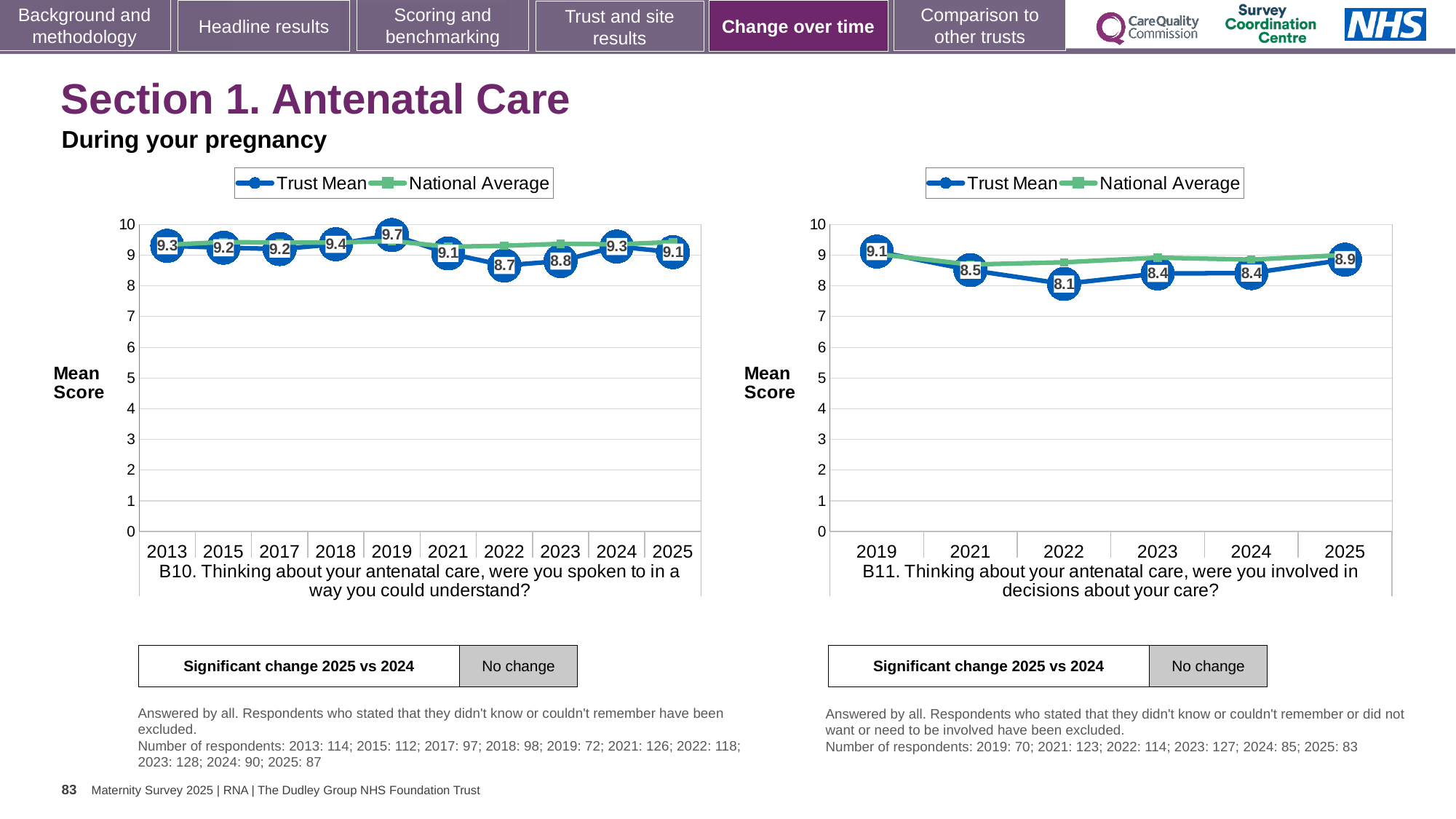
In the B10 chart (left), what is the difference between the Trust Mean scores for 2019 and 2022? 1.0 In the B11 chart (right), what is the Trust Mean score for 2025? 8.9 In the B10 chart (left), what is the Trust Mean score for 2019? 9.7 In the B10 chart (left), how many years are shown on the x axis? 10 In the B11 chart (right), which year has the lowest Trust Mean score? 2022 In the B11 chart (right), is the Trust Mean value for 2022 greater or less than 9? less How many series does the legend of the B11 chart (right) list? 2 What kind of chart is the B10 chart (left)? Line chart In the B11 chart (right), is the Trust Mean score for 2019 or 2021 higher? 2019 In the B10 chart (left), which year has the lowest Trust Mean score? 2022 In the B10 chart (left), which year has the highest Trust Mean score? 2019 In the B10 chart (left), what is the Trust Mean score for 2022? 8.7